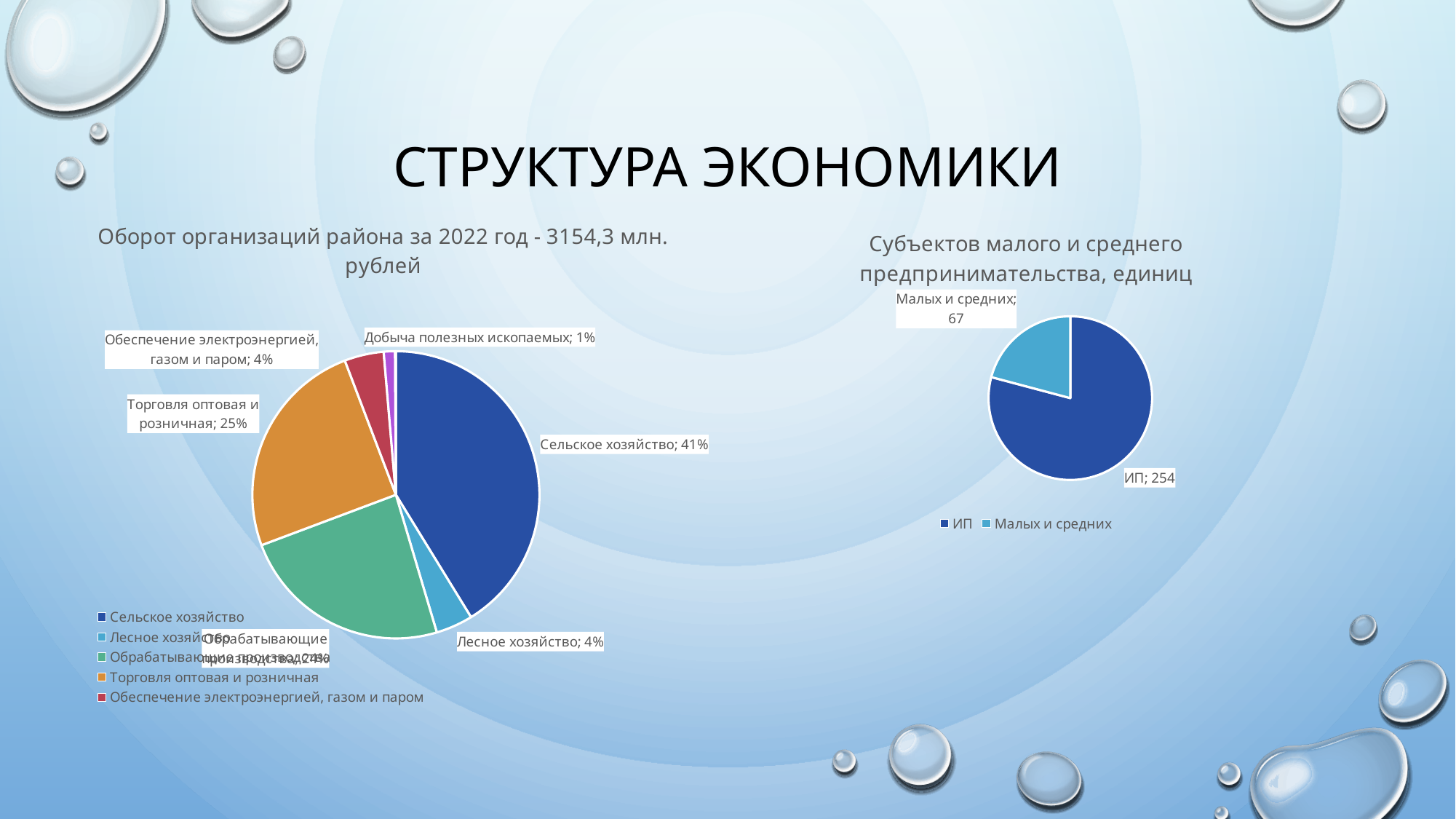
How many entries does the legend of the right chart (Субъектов малого и среднего предпринимательства) list? 2 In the right chart (Субъектов малого и среднего предпринимательства), what is the difference between 'ИП' and 'Малых и средних'? 187 In the right chart (Субъектов малого и среднего предпринимательства), what is the value for 'Малых и средних'? 67 In the left chart (Оборот организаций района), by how many percentage points does 'Сельское хозяйство' exceed 'Торговля оптовая и розничная'? 16% In the left chart (Оборот организаций района), what share does 'Добыча полезных ископаемых' have? 1% What kind of chart is the left chart titled 'Оборот организаций района за 2022 год - 3154,3 млн. рублей'? pie chart In the right chart (Субъектов малого и среднего предпринимательства), what is the value for 'ИП'? 254 In the left chart (Оборот организаций района), which is larger: 'Торговля оптовая и розничная' or 'Лесное хозяйство'? Торговля оптовая и розничная In the left chart (Оборот организаций района), which category has the largest slice? Сельское хозяйство In the left chart (Оборот организаций района), what share does 'Сельское хозяйство' have? 41% In the left chart (Оборот организаций района), what share does 'Торговля оптовая и розничная' have? 25%